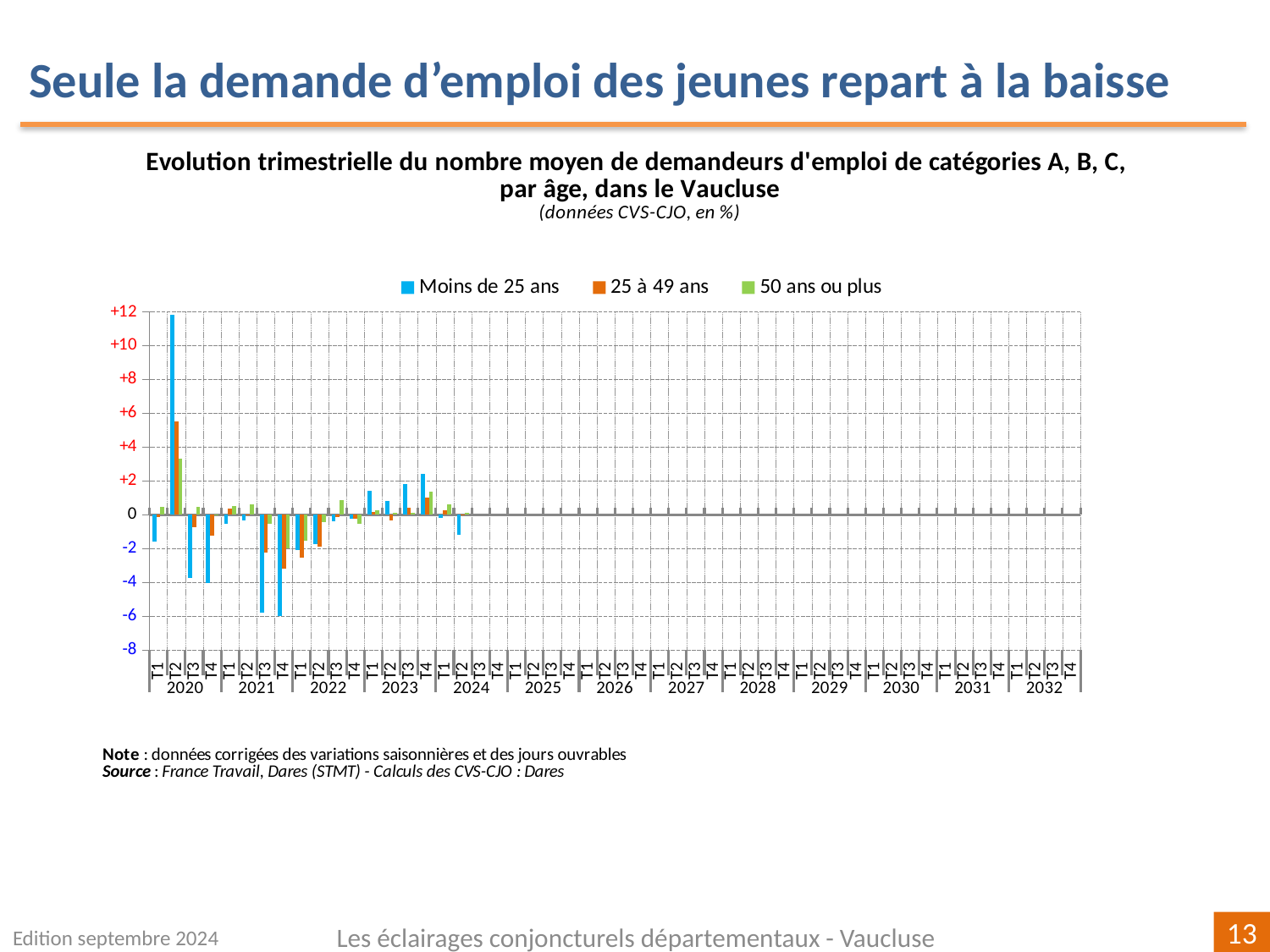
Is the value for Moins de 25 ans in 2020 T2 greater or less than +10? greater What kind of chart is shown on the slide? Bar chart Which series has the lowest value in 2024 T2? Moins de 25 ans How many years are labelled along the x axis? 13 Which series has the highest bar in 2020 T2? Moins de 25 ans Is the value for 25 à 49 ans in 2020 T2 greater or less than +4? greater How many series does the legend list? 3 In 2020 T2, which is larger: the value for Moins de 25 ans or the value for 25 à 49 ans? Moins de 25 ans Is the value for 50 ans ou plus in 2020 T2 greater or less than +2? greater What are the three series named in the legend? Moins de 25 ans, 25 à 49 ans, 50 ans ou plus In which unit are the values expressed, according to the chart subtitle? %